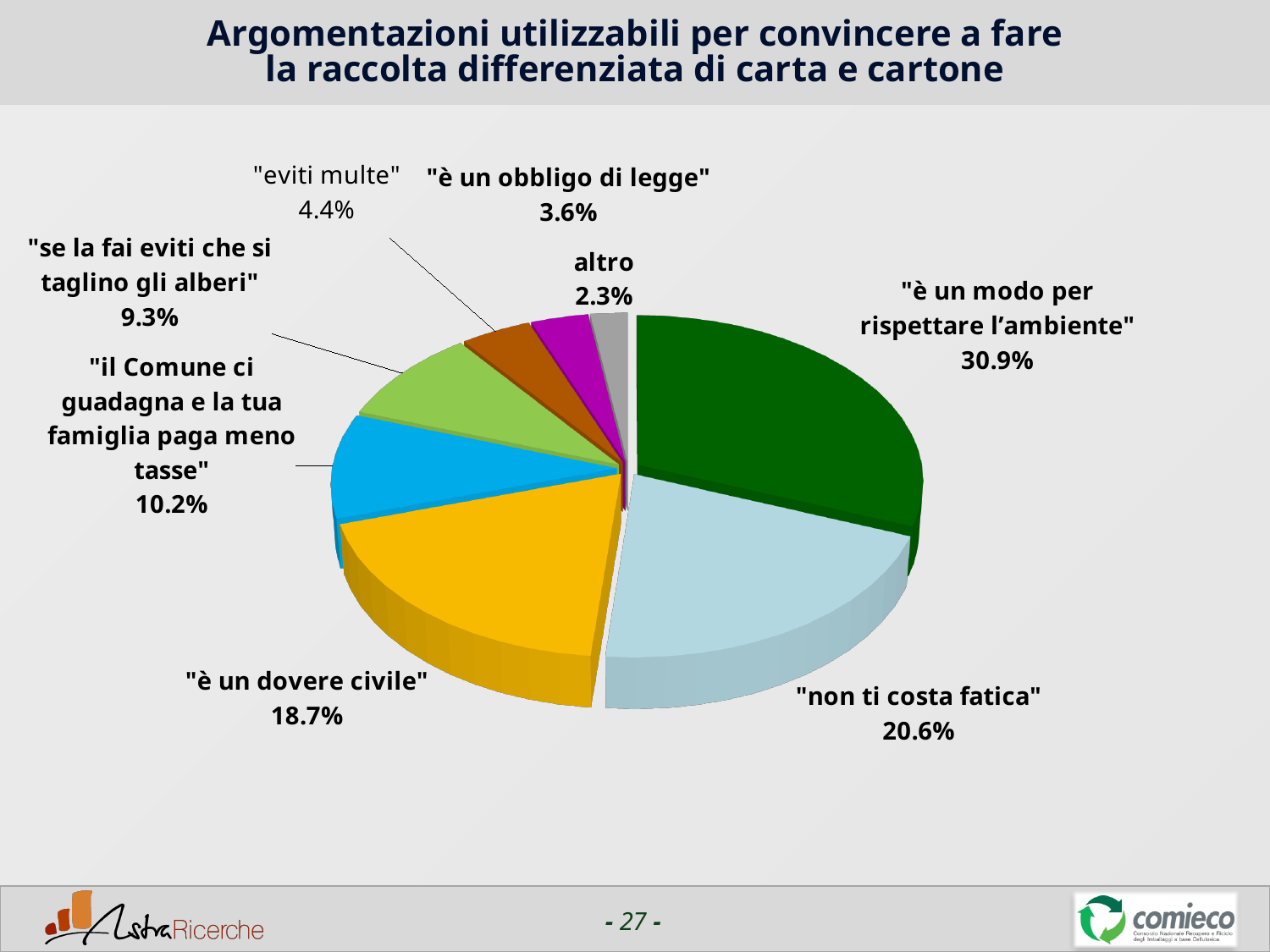
Which is larger: "il Comune ci guadagna e la tua famiglia paga meno tasse" or "se la fai eviti che si taglino gli alberi"? "il Comune ci guadagna e la tua famiglia paga meno tasse" Which slice of the pie chart is the largest? "è un modo per rispettare l'ambiente" What percentage is shown for "è un dovere civile"? 18.7% What percentage is shown for "non ti costa fatica"? 20.6% What is the difference in percentage points between "non ti costa fatica" and "è un dovere civile"? 1.9 What percentage is shown for "è un modo per rispettare l'ambiente"? 30.9% Which slice of the pie chart is the smallest? altro What percentage is shown for "eviti multe"? 4.4% What kind of chart is shown on the slide? pie chart What percentage is shown for "altro"? 2.3% How many slices does the pie chart have? 8 What is the title of the slide? Argomentazioni utilizzabili per convincere a fare la raccolta differenziata di carta e cartone